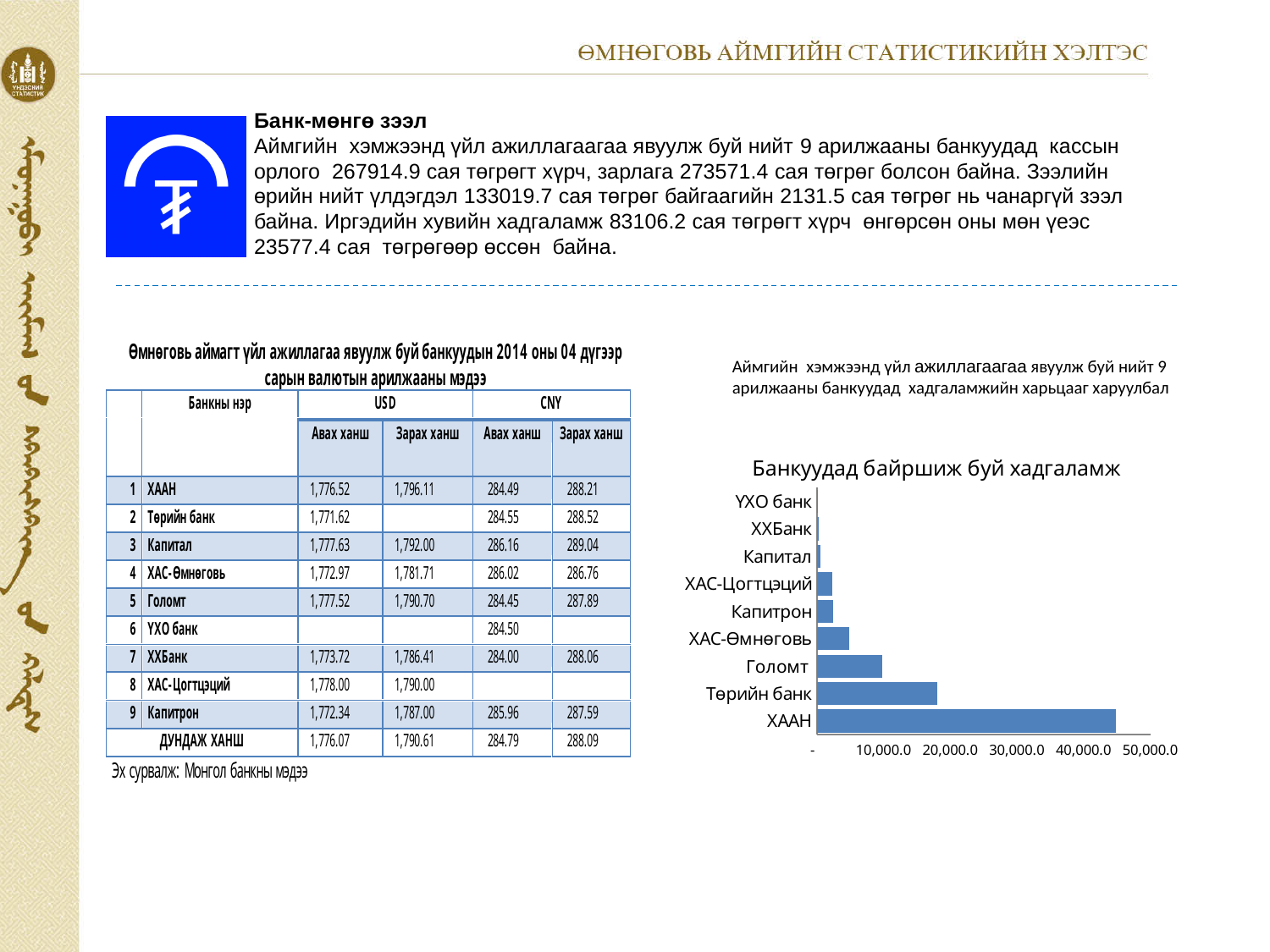
Is the value for Төрийн банк greater or less than 10,000.0? greater How many banks are listed on the chart "Банкуудад байршиж буй хадгаламж"? 9 What is the title of the bar chart on the slide? Банкуудад байршиж буй хадгаламж Which bank has the highest value on the chart "Банкуудад байршиж буй хадгаламж"? ХААН Which has the larger value, Төрийн банк or Голомт? Төрийн банк Is the value for ХААН greater or less than 40,000.0? greater Which has the larger value, ХААН or Төрийн банк? ХААН Is the value for ХАС-Өмнөговь greater or less than 10,000.0? less Which has the larger value, Голомт or ХАС-Өмнөговь? Голомт What kind of chart is shown on the slide? bar chart